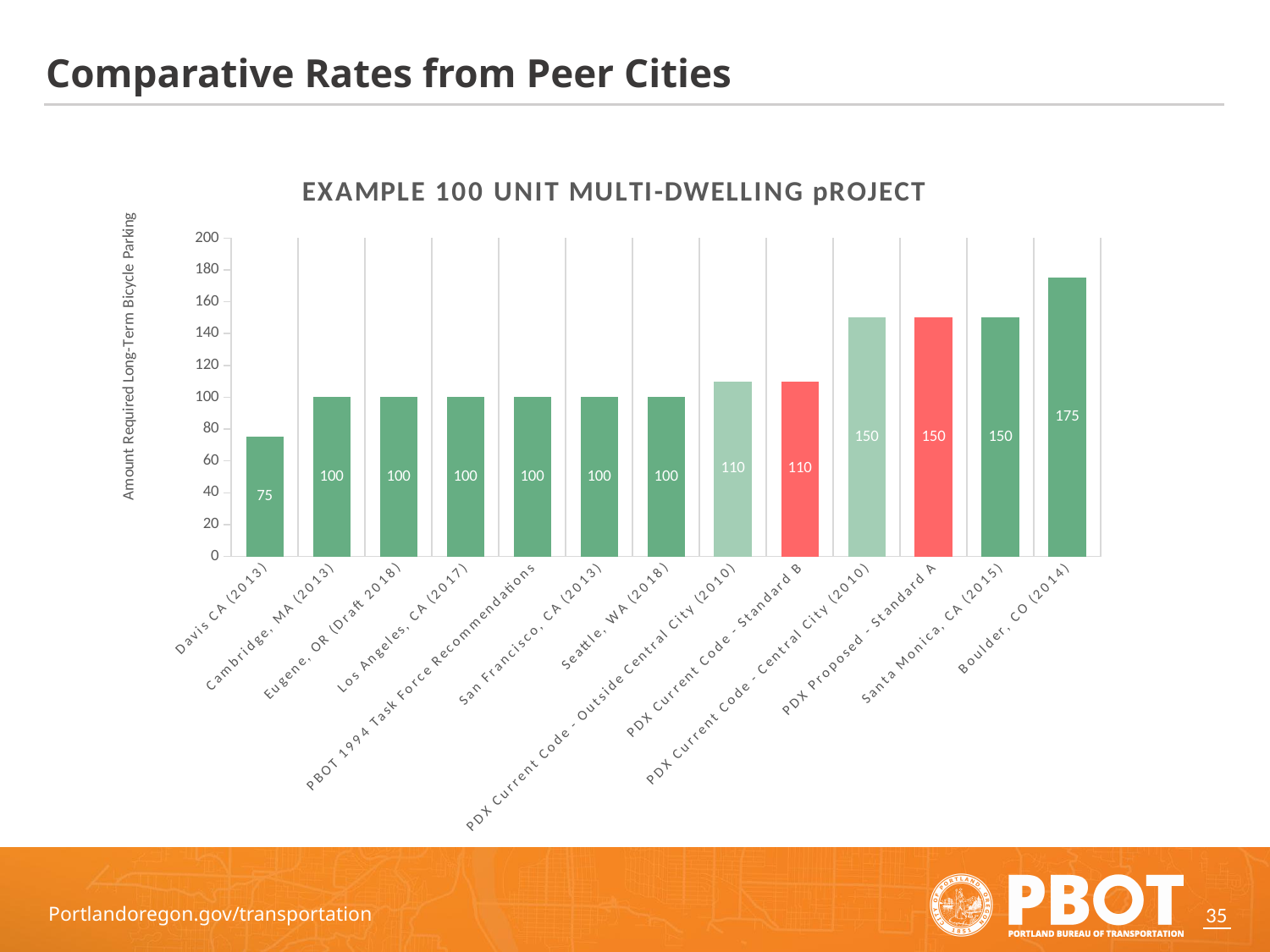
What is the value for PDX Current Code - Standard B? 110 What is the value for Boulder, CO (2014)? 175 What is the value for Santa Monica, CA (2015)? 150 Which is larger, the value for Seattle, WA (2018) or the value for PDX Current Code - Outside Central City (2010)? PDX Current Code - Outside Central City (2010) Which category has the highest value? Boulder, CO (2014) What is the value for Davis CA (2013)? 75 Which category has the lowest value? Davis CA (2013) What is the difference between the values for Boulder, CO (2014) and Davis CA (2013)? 100 What kind of chart is shown on the slide? Bar chart What is the difference between the values for PDX Proposed - Standard A and PDX Current Code - Standard B? 40 How many categories are shown on the x axis? 13 What is the label of the vertical axis? Amount Required Long-Term Bicycle Parking